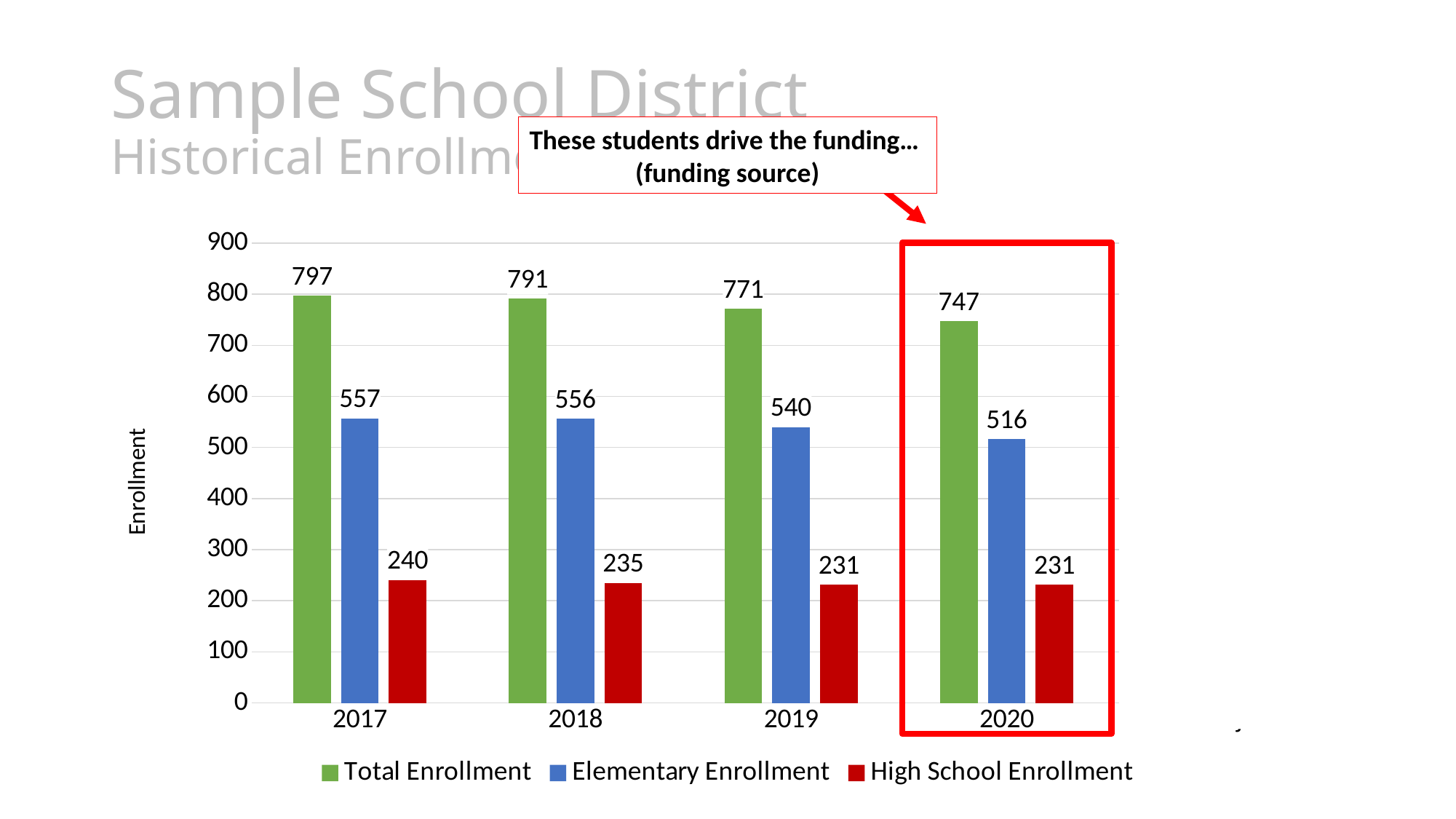
In which year was Elementary Enrollment lowest? 2020 How many years are shown on the x axis? 4 What was the Elementary Enrollment in 2019? 540 How many series does the legend list? 3 What was the High School Enrollment in 2020? 231 What is the difference between Elementary Enrollment and High School Enrollment in 2018? 321 Which is larger: Elementary Enrollment in 2017 or Elementary Enrollment in 2020? Elementary Enrollment in 2017 In which year was Total Enrollment highest? 2017 What kind of chart is shown on the slide? Bar chart What was the Total Enrollment in 2017? 797 Does Total Enrollment rise or fall from 2017 to 2020? Fall What is the difference between Total Enrollment in 2017 and in 2020? 50